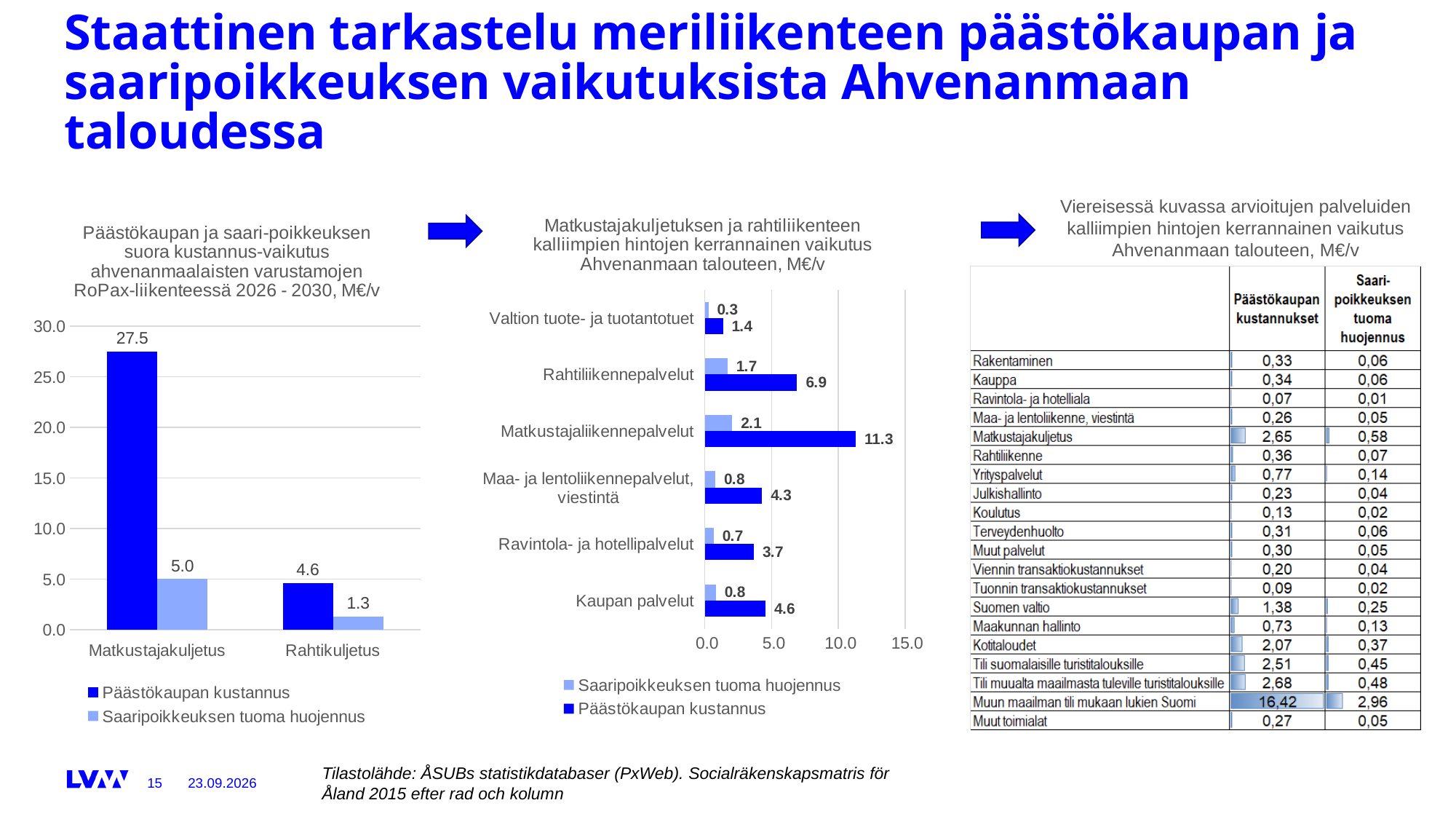
In the left chart, what is the difference between the Päästökaupan kustannus and the Saaripoikkeuksen tuoma huojennus for Matkustajakuljetus? 22.5 What kind of chart is the left chart? Bar chart In the middle chart, which category has the highest Päästökaupan kustannus value? Matkustajaliikennepalvelut In the middle chart, what is the difference between the Päästökaupan kustannus and the Saaripoikkeuksen tuoma huojennus for Rahtiliikennepalvelut? 5.2 In the left chart, what is the Päästökaupan kustannus value for Matkustajakuljetus? 27.5 In the middle chart, what is the Päästökaupan kustannus value for Matkustajaliikennepalvelut? 11.3 In the left chart, what is the Saaripoikkeuksen tuoma huojennus value for Rahtikuljetus? 1.3 In the middle chart, how many categories are shown? 6 In the middle chart, which category has the lowest Päästökaupan kustannus value? Valtion tuote- ja tuotantotuet In the middle chart, what is the Saaripoikkeuksen tuoma huojennus value for Rahtiliikennepalvelut? 1.7 In the left chart, how many series does the legend list? 2 In the middle chart, which is larger: the Päästökaupan kustannus for Kaupan palvelut or for Ravintola- ja hotellipalvelut? Kaupan palvelut